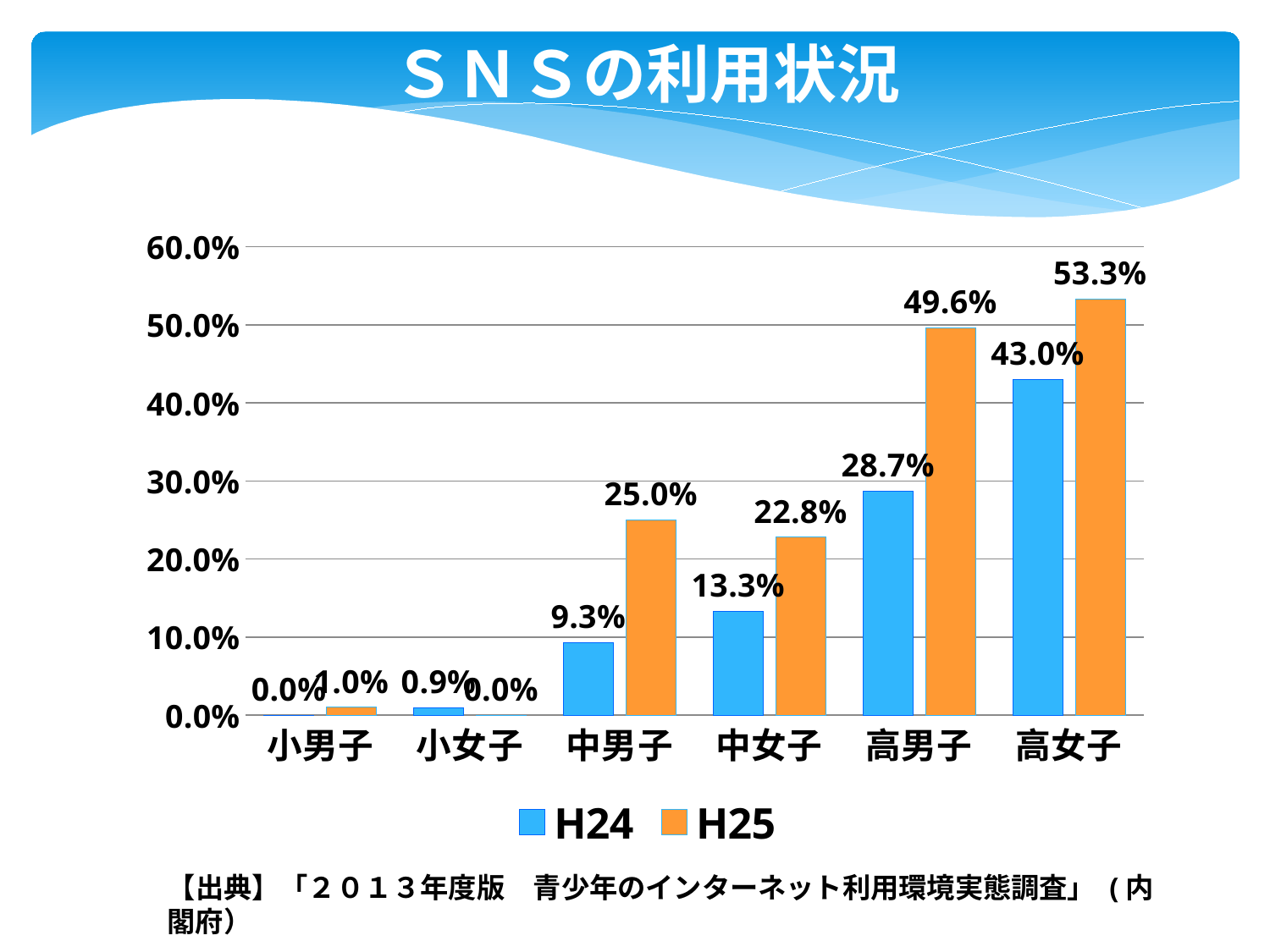
What is the H25 value for 高男子? 49.6% Which is larger, the H25 value for 中男子 or the H25 value for 中女子? 中男子 How many series does the legend list? 2 How many categories are shown on the x axis? 6 What is the H24 value for 中男子? 9.3% What is the title of the chart? ＳＮＳの利用状況 What kind of chart is shown on the slide? bar chart What is the H24 value for 中女子? 13.3% What is the difference between the H25 and H24 values for 高男子? 20.9% Which category has the highest H25 value? 高女子 Which category has the lowest H24 value? 小男子 What is the H25 value for 高女子? 53.3%